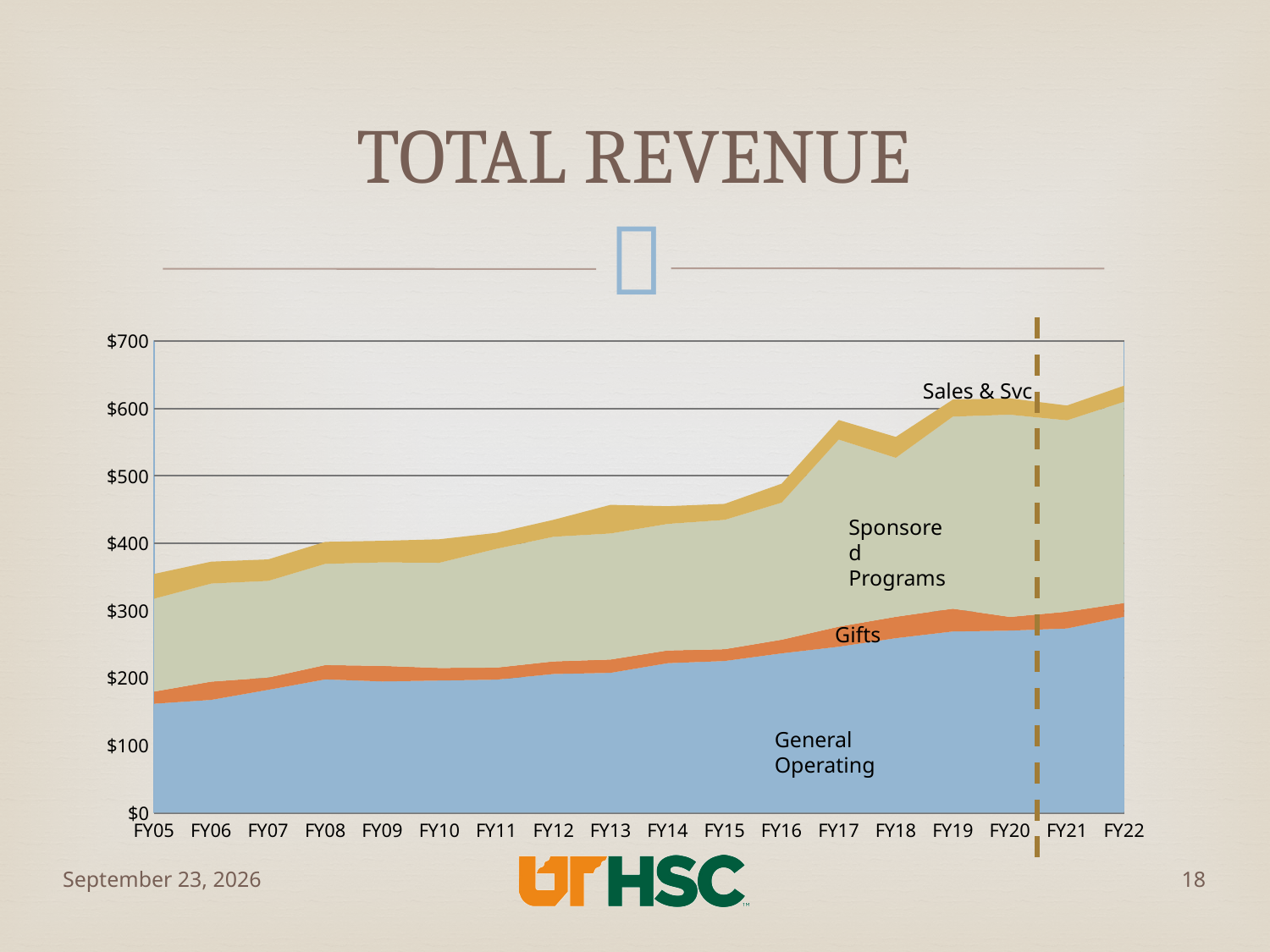
What is the title of the chart? TOTAL REVENUE Is the total revenue in FY17 greater or less than $500? greater How many fiscal years are shown along the x axis? 18 Is the total revenue in FY22 greater or less than $600? greater Is the General Operating value in FY05 greater or less than $200? less Which fiscal year has the lowest total revenue? FY05 Does total revenue generally rise or fall from FY05 to FY22? Rise Which series is plotted at the bottom of the stack? General Operating Which is larger, the total revenue in FY17 or in FY18? FY17 How many revenue series are labelled in the chart? 4 What kind of chart is shown on the slide? Stacked area chart